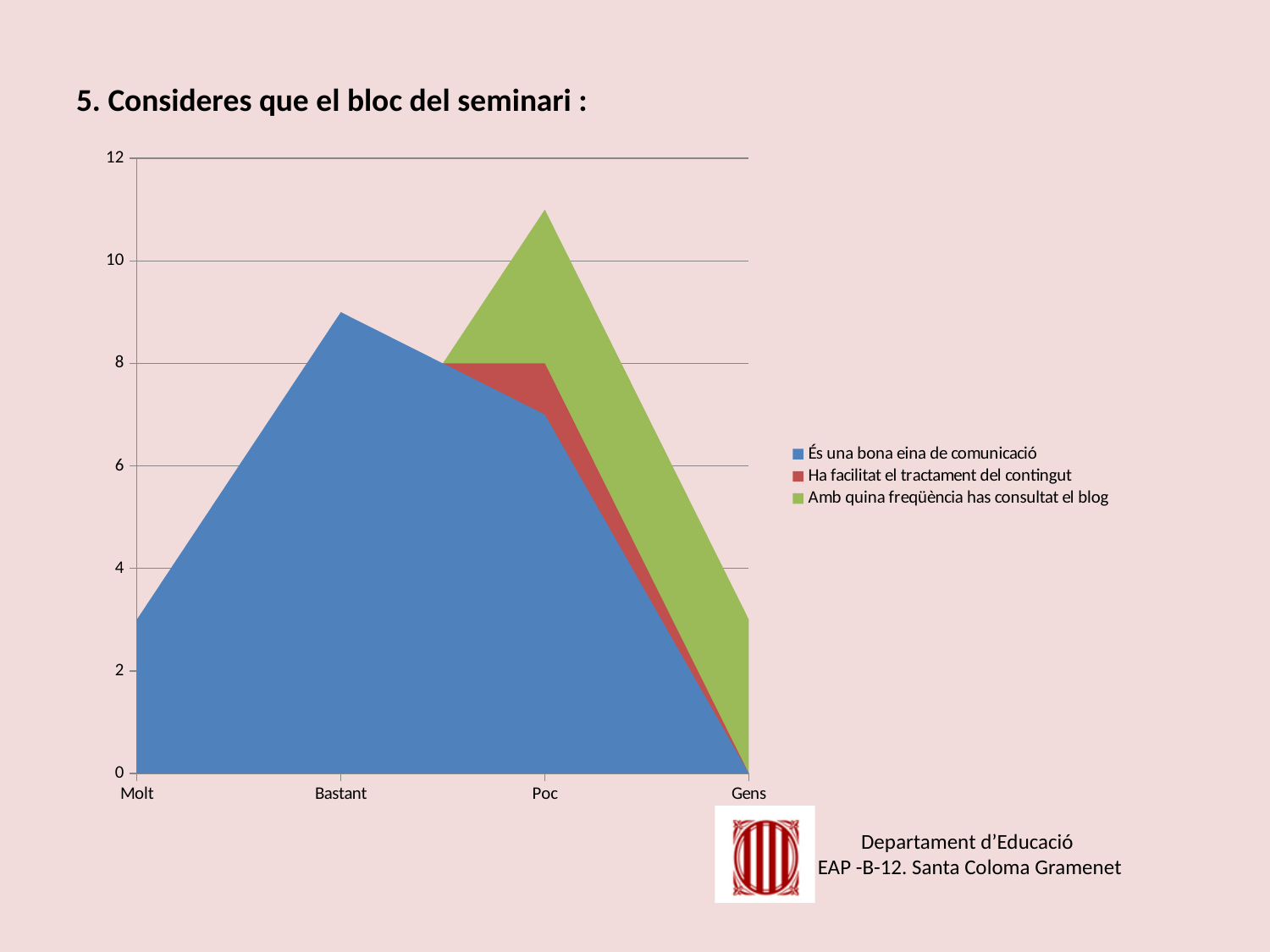
At Poc, which is larger: 'Amb quina freqüència has consultat el blog' or 'Ha facilitat el tractament del contingut'? Amb quina freqüència has consultat el blog What is the value of 'Ha facilitat el tractament del contingut' for Poc? 8 What kind of chart is shown on the slide? Area chart How many categories are shown on the x axis? 4 What is the title of the chart? 5. Consideres que el bloc del seminari : Is the value of 'Amb quina freqüència has consultat el blog' for Poc greater or less than 10? greater Is the value of 'És una bona eina de comunicació' for Bastant greater or less than 8? greater What is the value of 'És una bona eina de comunicació' for Gens? 0 Is the value of 'És una bona eina de comunicació' for Molt greater or less than 4? less For which category does 'Amb quina freqüència has consultat el blog' reach its highest value? Poc How many series does the legend list? 3